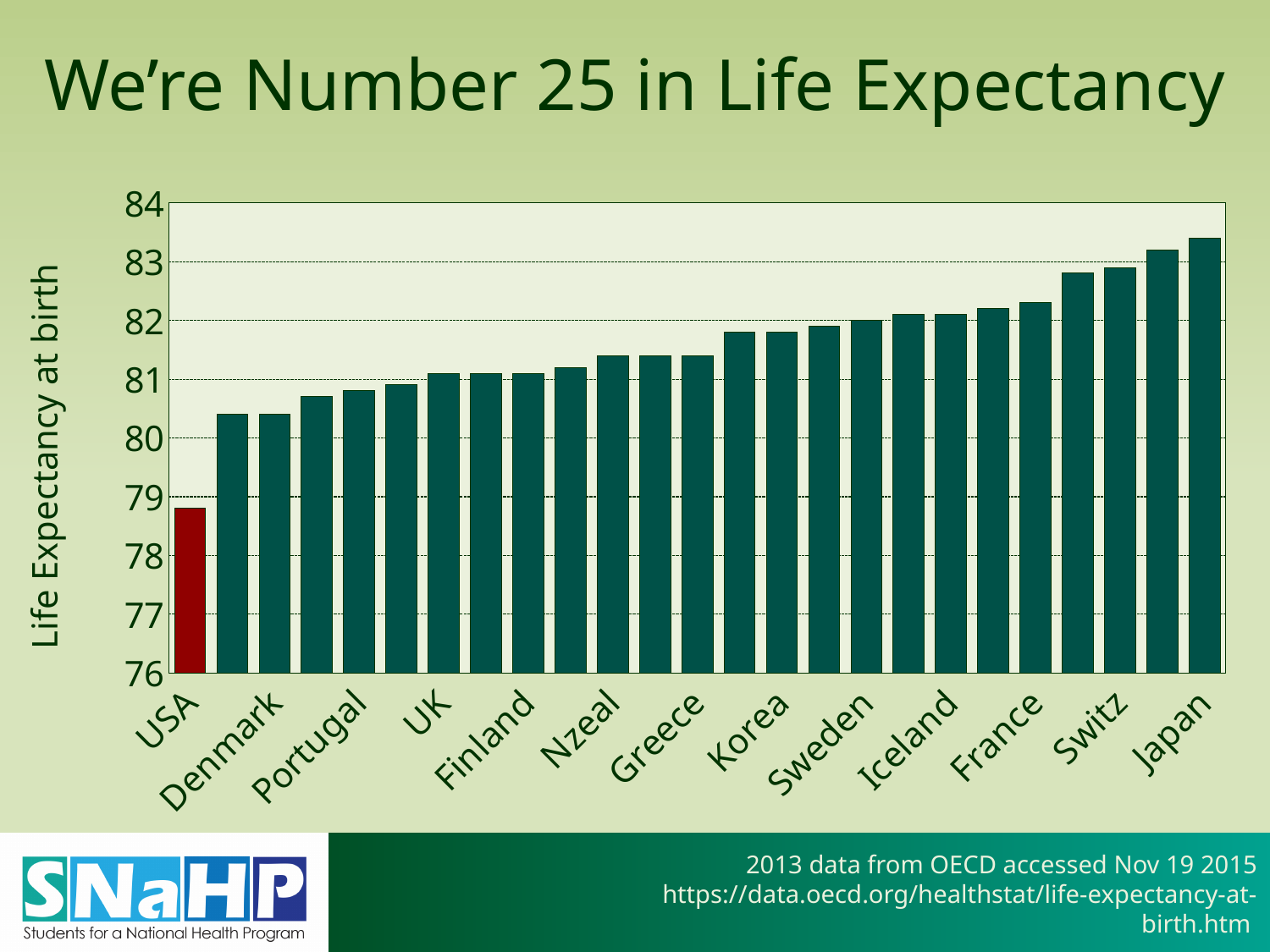
Do the values rise or fall moving from left to right along the x axis? rise Which country has the lowest life expectancy at birth in the chart? USA Is the value for USA greater or less than 79? less What colour is the bar for USA? red Is the value for Portugal greater or less than 81? less Is the value for Korea greater or less than 82? less What kind of chart is shown on the slide? bar chart Which country has the highest life expectancy at birth in the chart? Japan Which has the higher life expectancy, Greece or Switz? Switz